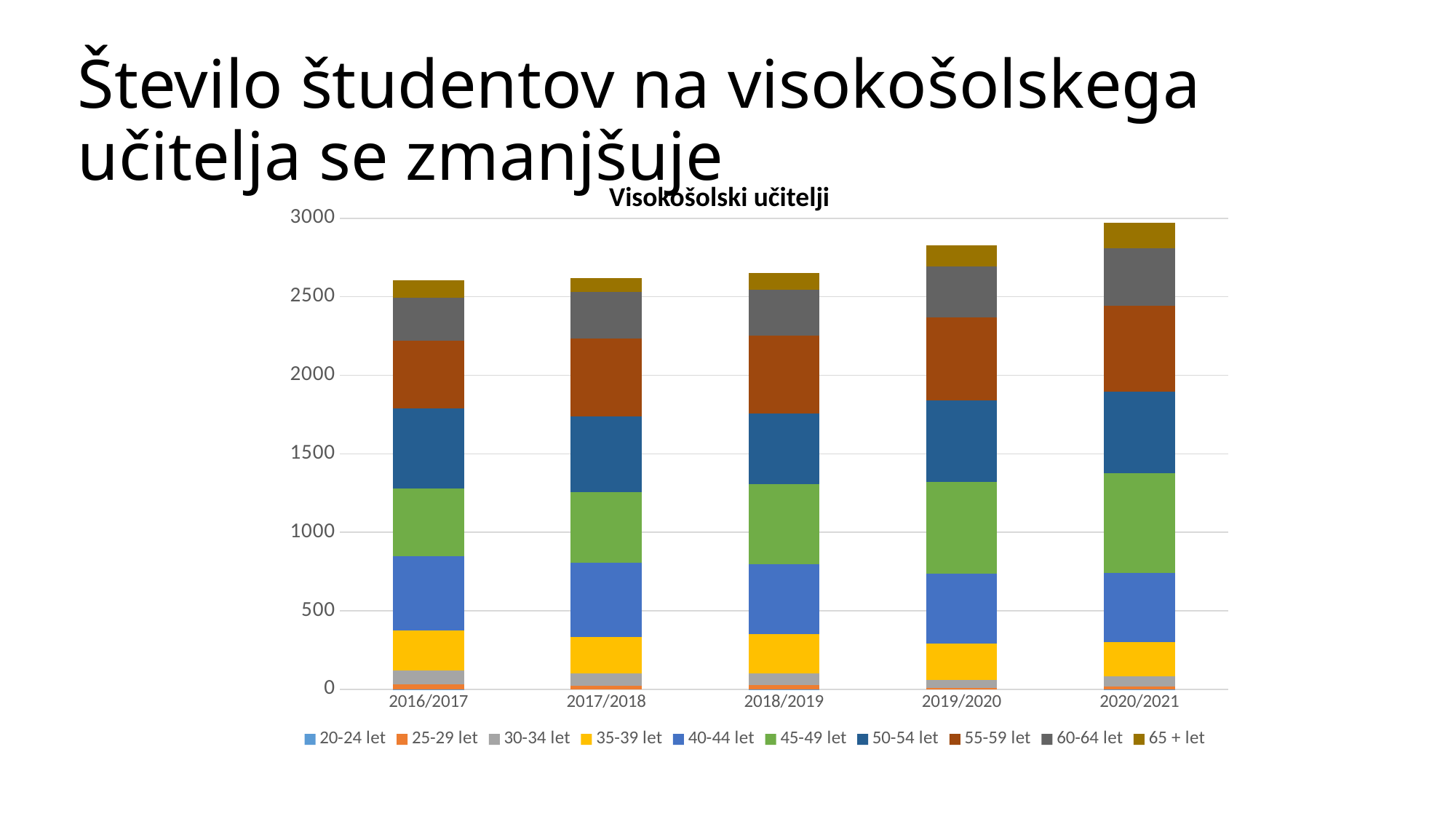
Do the total bar heights rise or fall from 2016/2017 to 2020/2021? rise Is the total bar for 2019/2020 greater or less than 2500? greater What kind of chart is shown on the slide? stacked bar chart Is the total bar for 2018/2019 greater or less than 3000? less How many series does the legend list? 10 Is the total bar for 2020/2021 greater or less than 2500? greater How many academic years (categories) are shown on the x axis? 5 Which colour represents the 45-49 let series in the legend? green What is the title of the chart? Visokošolski učitelji Which academic year has the highest total bar? 2020/2021 Which total bar is larger, 2016/2017 or 2020/2021? 2020/2021